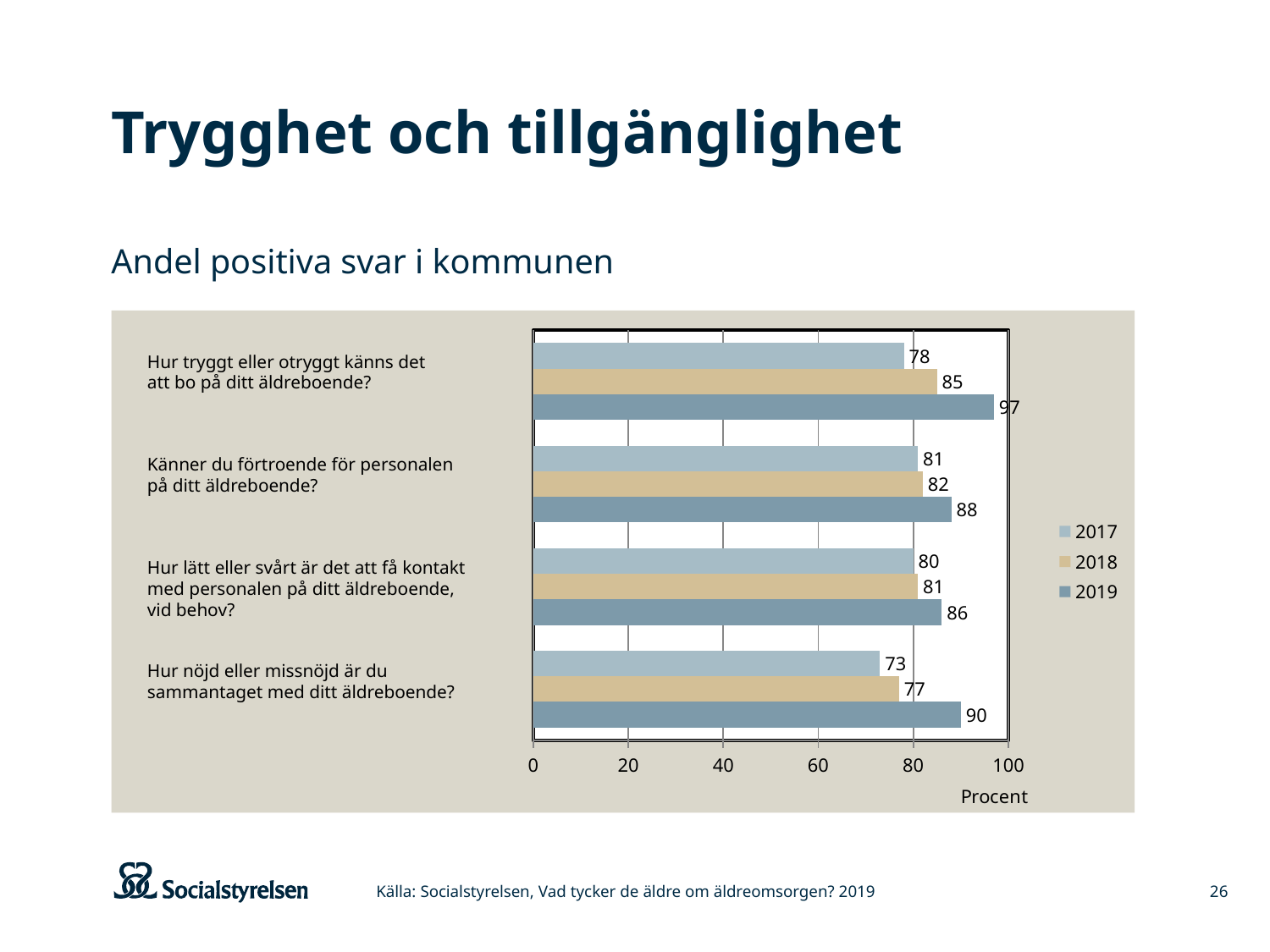
What is the difference between the 2019 and 2017 values for "Hur nöjd eller missnöjd är du sammantaget med ditt äldreboende?"? 17 What kind of chart is shown on the slide? Bar chart Which question has the highest 2019 value? Hur tryggt eller otryggt känns det att bo på ditt äldreboende? How many questions (categories) are shown in the chart? 4 Which is larger for "Hur lätt eller svårt är det att få kontakt med personalen på ditt äldreboende, vid behov?": the 2018 value or the 2019 value? 2019 What is the 2018 value for "Känner du förtroende för personalen på ditt äldreboende?"? 82 Which question has the lowest 2017 value? Hur nöjd eller missnöjd är du sammantaget med ditt äldreboende? What is the 2017 value for "Hur nöjd eller missnöjd är du sammantaget med ditt äldreboende?"? 73 Is the 2017 value for "Hur tryggt eller otryggt känns det att bo på ditt äldreboende?" greater or less than 60? greater How many series does the legend list? 3 What is the label on the horizontal axis of the chart? Procent What is the 2019 value for "Hur tryggt eller otryggt känns det att bo på ditt äldreboende?"? 97